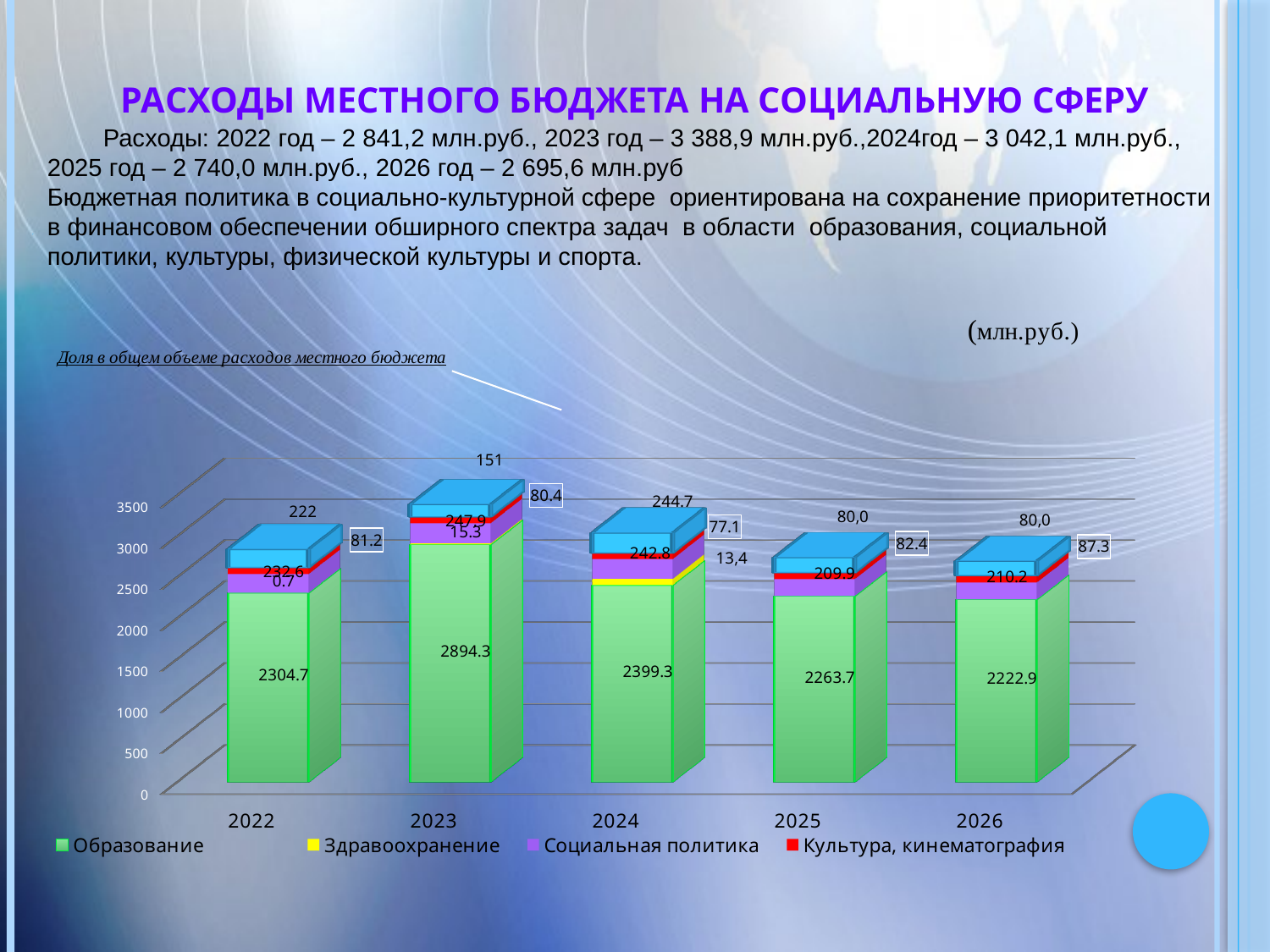
Which is larger, the Образование value for 2024 or for 2025? 2024 What type of chart is shown on the slide? bar chart What is the difference between the Образование values for 2023 and 2022? 589.6 What is the value for Социальная политика in 2025? 209.9 In which year is the value for Образование the highest? 2023 How many series does the chart legend list? 4 In which year is the value for Образование the lowest? 2026 How many years (categories) are shown on the x axis of the chart? 5 What is the value for Образование in 2026? 2222.9 Is the total height of the stacked bar for 2023 greater or less than 3000? greater What is the value for Образование in 2023? 2894.3 What is the value for Образование in 2022? 2304.7